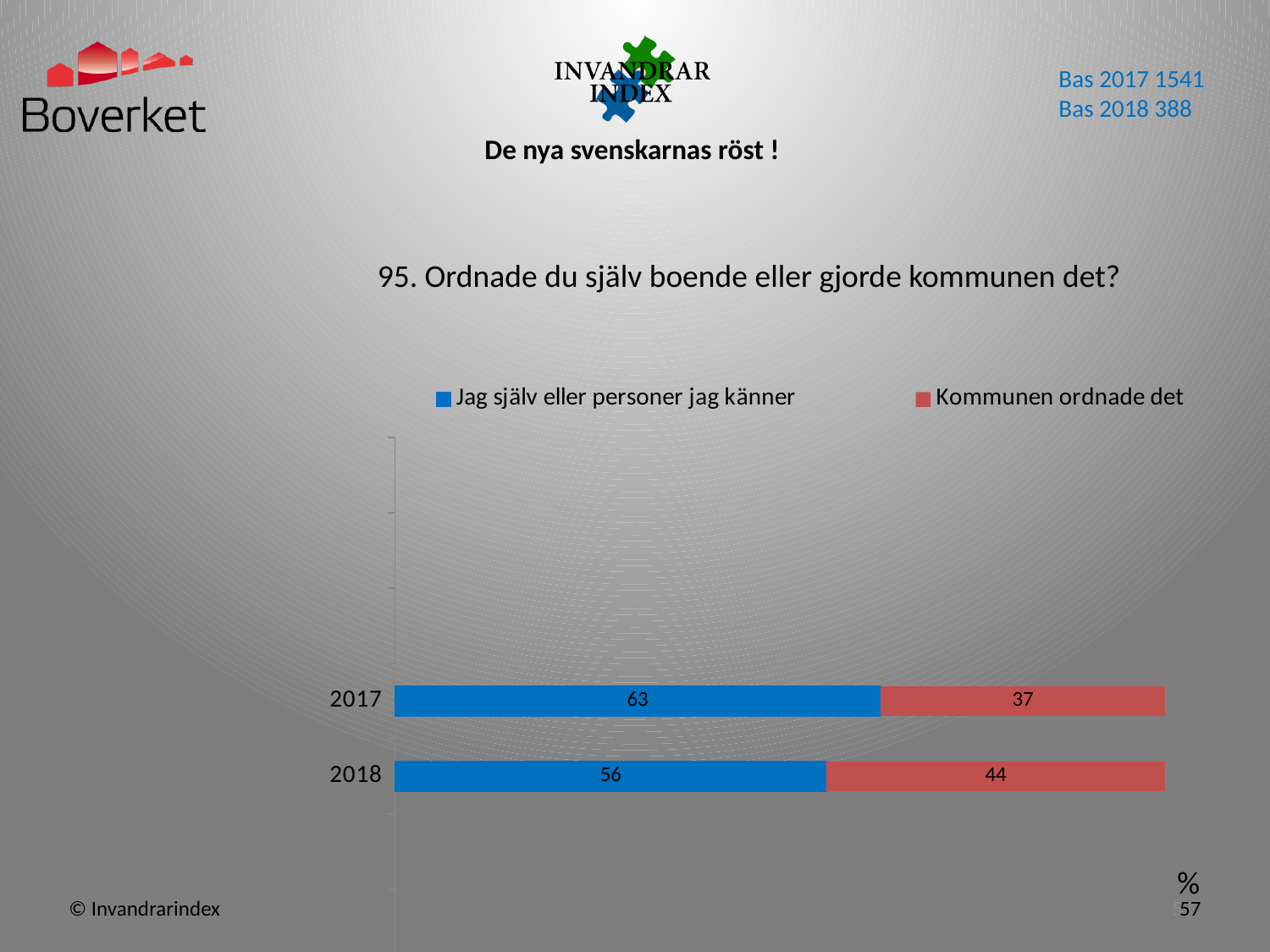
What is the value for "Kommunen ordnade det" in 2018? 44 How many series does the legend list? 2 What kind of chart is shown on the slide? Stacked bar chart In which year is the value for "Kommunen ordnade det" lowest? 2017 What is the value for "Jag själv eller personer jag känner" in 2017? 63 What is the total of the stacked bar for 2018? 100 In which year is the value for "Jag själv eller personer jag känner" highest? 2017 Which is larger in 2018: "Jag själv eller personer jag känner" or "Kommunen ordnade det"? Jag själv eller personer jag känner How many years (categories) are shown in the chart? 2 What is the value for "Kommunen ordnade det" in 2017? 37 What is the difference between the 2017 and 2018 values for "Jag själv eller personer jag känner"? 7 What is the value for "Jag själv eller personer jag känner" in 2018? 56